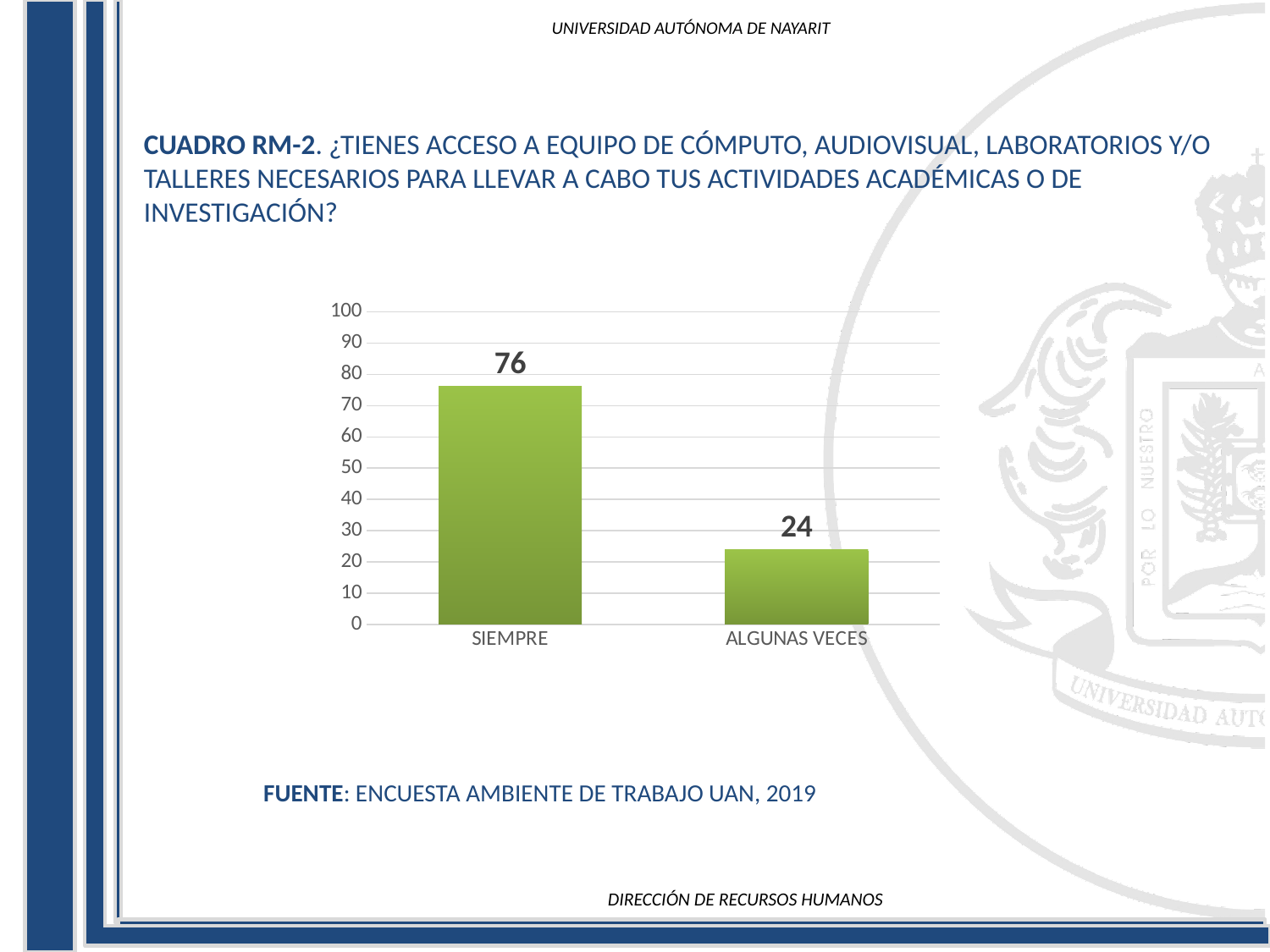
What is the value for SIEMPRE? 76 What is the maximum value shown on the vertical axis? 100 Which category has the highest value? SIEMPRE Is the value for SIEMPRE greater or less than 70? greater What kind of chart is shown on the slide? bar chart How many categories are shown on the x axis? 2 Is the value for ALGUNAS VECES greater or less than 30? less Which is larger, the value for SIEMPRE or the value for ALGUNAS VECES? SIEMPRE What is the difference between the values for SIEMPRE and ALGUNAS VECES? 52 Which category has the lowest value? ALGUNAS VECES What is the total of the two values shown in the chart? 100 What is the value for ALGUNAS VECES? 24